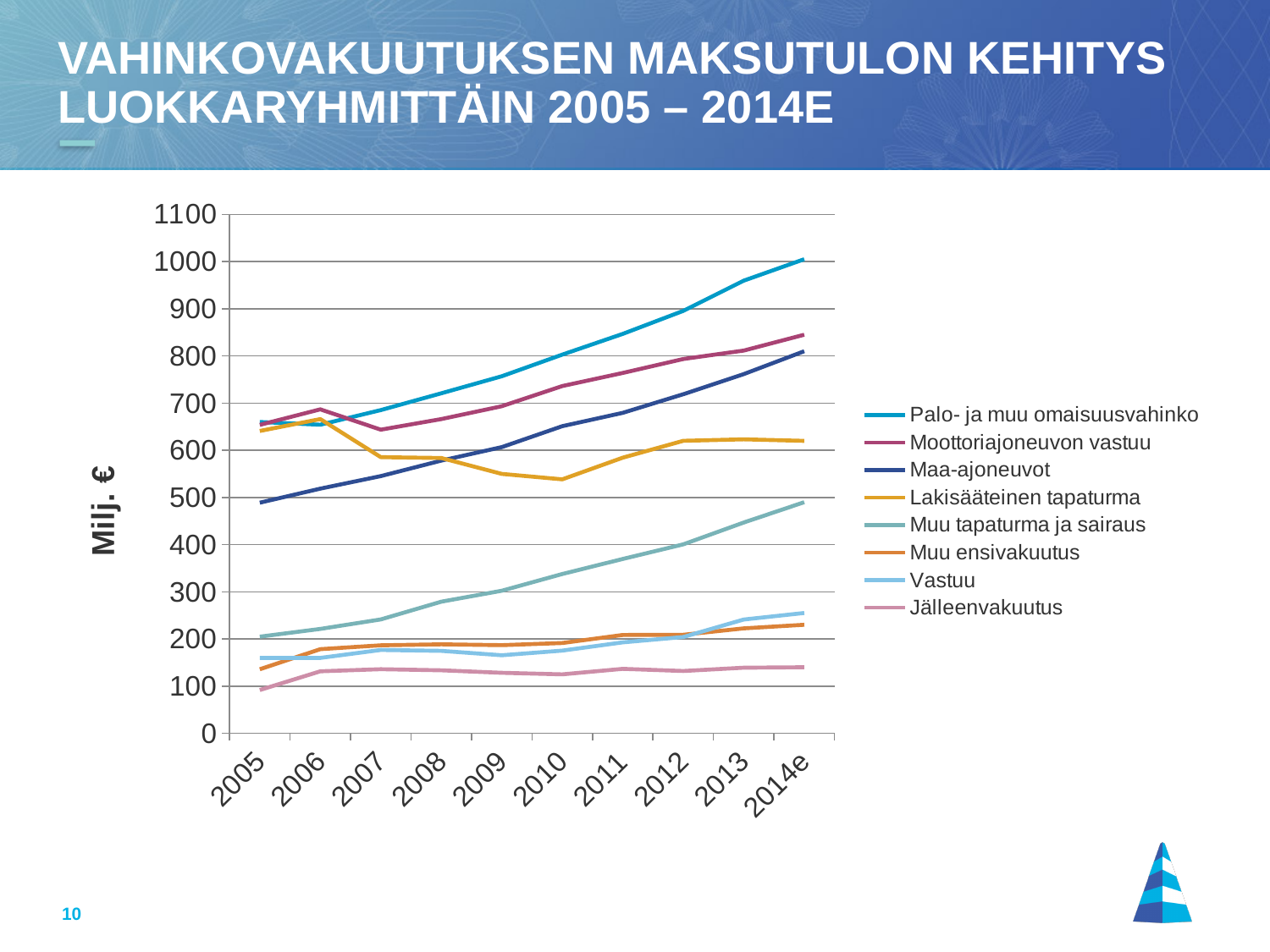
Is the value for Palo- ja muu omaisuusvahinko in 2014e greater or less than 900? greater Which series has the lowest value in 2014e? Jälleenvakuutus What kind of chart is shown on the slide? line chart How many years are shown along the x axis? 10 Is the value for Muu tapaturma ja sairaus in 2005 greater or less than 300? less Is the value for Lakisääteinen tapaturma in 2010 greater or less than 600? less Does the Palo- ja muu omaisuusvahinko series rise or fall from 2005 to 2014e? rise How many series does the legend list? 8 Which series has the highest value in 2014e? Palo- ja muu omaisuusvahinko What is the label on the y axis of the chart? Milj. € In 2014e, which is larger: Lakisääteinen tapaturma or Muu tapaturma ja sairaus? Lakisääteinen tapaturma